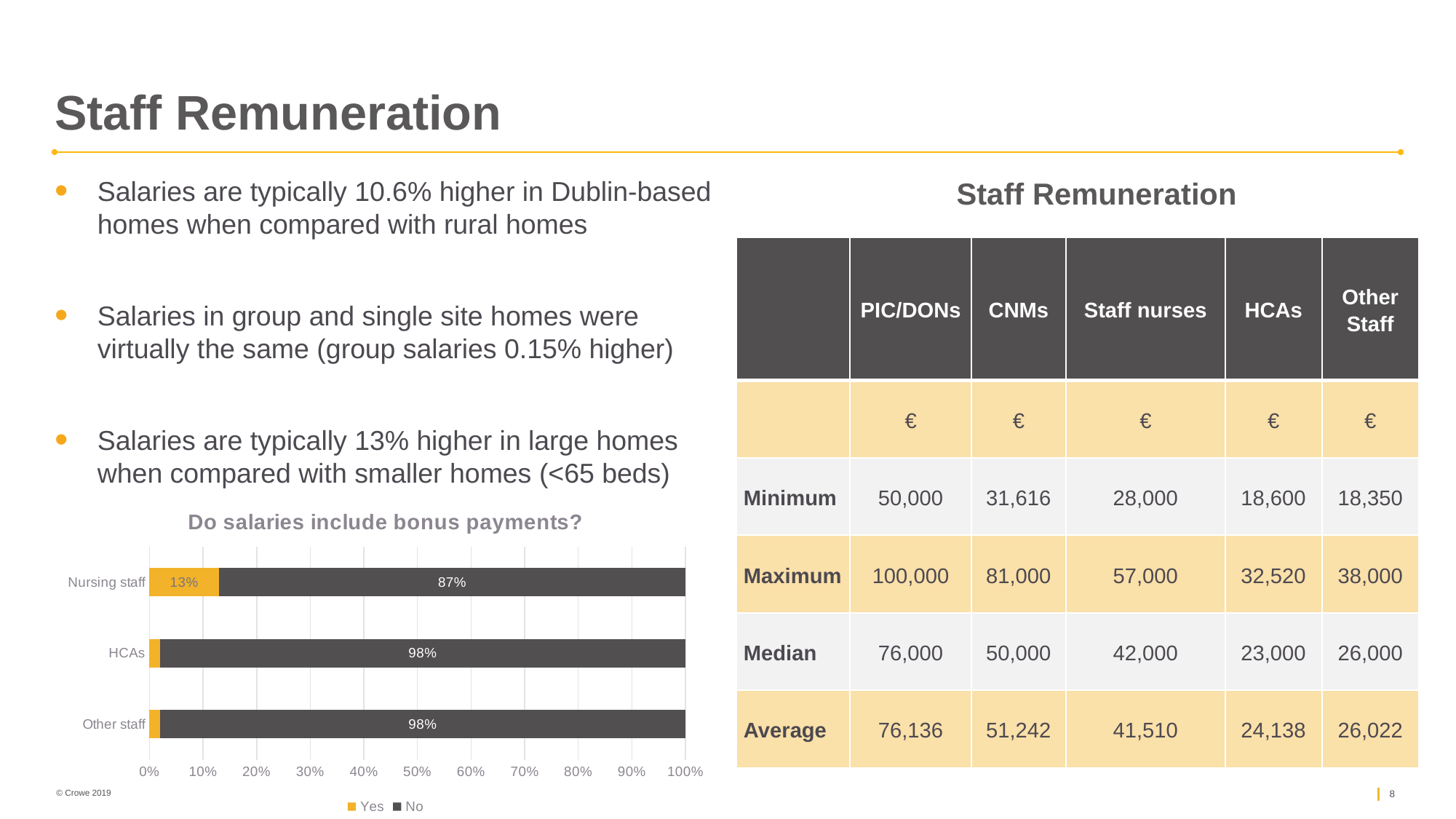
In the 'Do salaries include bonus payments?' chart, what is the 'No' value for Other staff? 98% In the 'Do salaries include bonus payments?' chart, what percentage of Nursing staff salaries include bonus payments (Yes)? 13% How many staff categories are shown in the 'Do salaries include bonus payments?' chart? 3 In the 'Do salaries include bonus payments?' chart, which staff category has the lowest 'No' share? Nursing staff In the 'Do salaries include bonus payments?' chart, what is the 'No' value for Nursing staff? 87% In the 'Do salaries include bonus payments?' chart, which staff category has the highest 'Yes' share? Nursing staff In the 'Do salaries include bonus payments?' chart, what is the 'No' value for HCAs? 98% In the 'Do salaries include bonus payments?' chart, is the 'No' value for Nursing staff larger or smaller than the 'No' value for Other staff? smaller In the 'Do salaries include bonus payments?' chart, what is the difference between the 'No' value for HCAs and the 'No' value for Nursing staff? 11% How many series does the legend of the 'Do salaries include bonus payments?' chart list? 2 In the 'Do salaries include bonus payments?' chart, is the 'Yes' value for HCAs greater or less than 10%? less What kind of chart is 'Do salaries include bonus payments?' bar chart